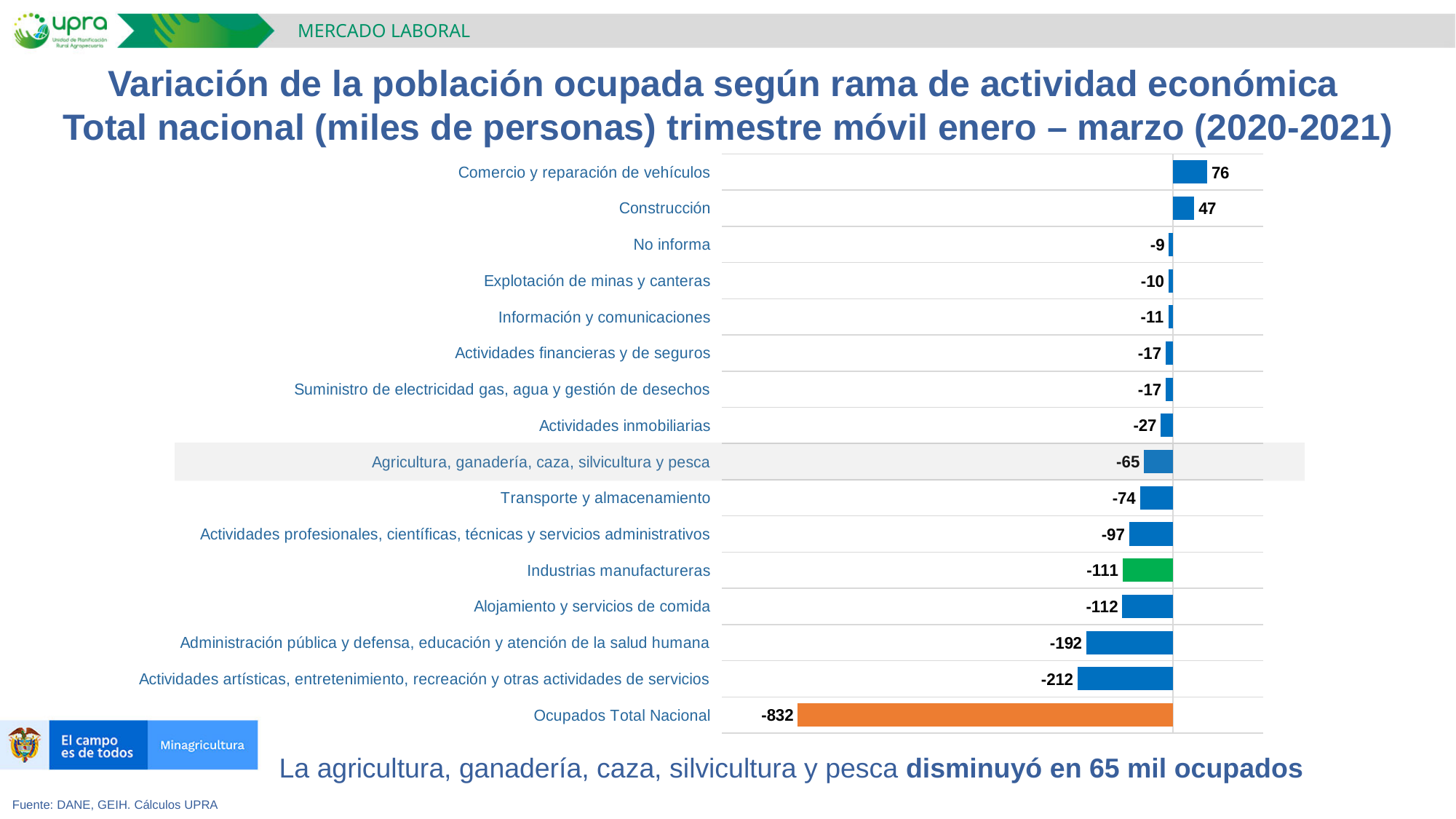
What is the value for Comercio y reparación de vehículos? 76 What is the value for Agricultura, ganadería, caza, silvicultura y pesca? -65 Which category has the highest value? Comercio y reparación de vehículos What is the value for Industrias manufactureras? -111 What is the difference between the values for Comercio y reparación de vehículos and Construcción? 29 What colour is the bar for Industrias manufactureras? Green How many categories are shown in the chart? 16 What is the value for Ocupados Total Nacional? -832 What kind of chart is shown on the slide? Bar chart Which is larger, the value for Transporte y almacenamiento or the value for Agricultura, ganadería, caza, silvicultura y pesca? Agricultura, ganadería, caza, silvicultura y pesca What is the value for Administración pública y defensa, educación y atención de la salud humana? -192 Which category has the lowest value? Ocupados Total Nacional